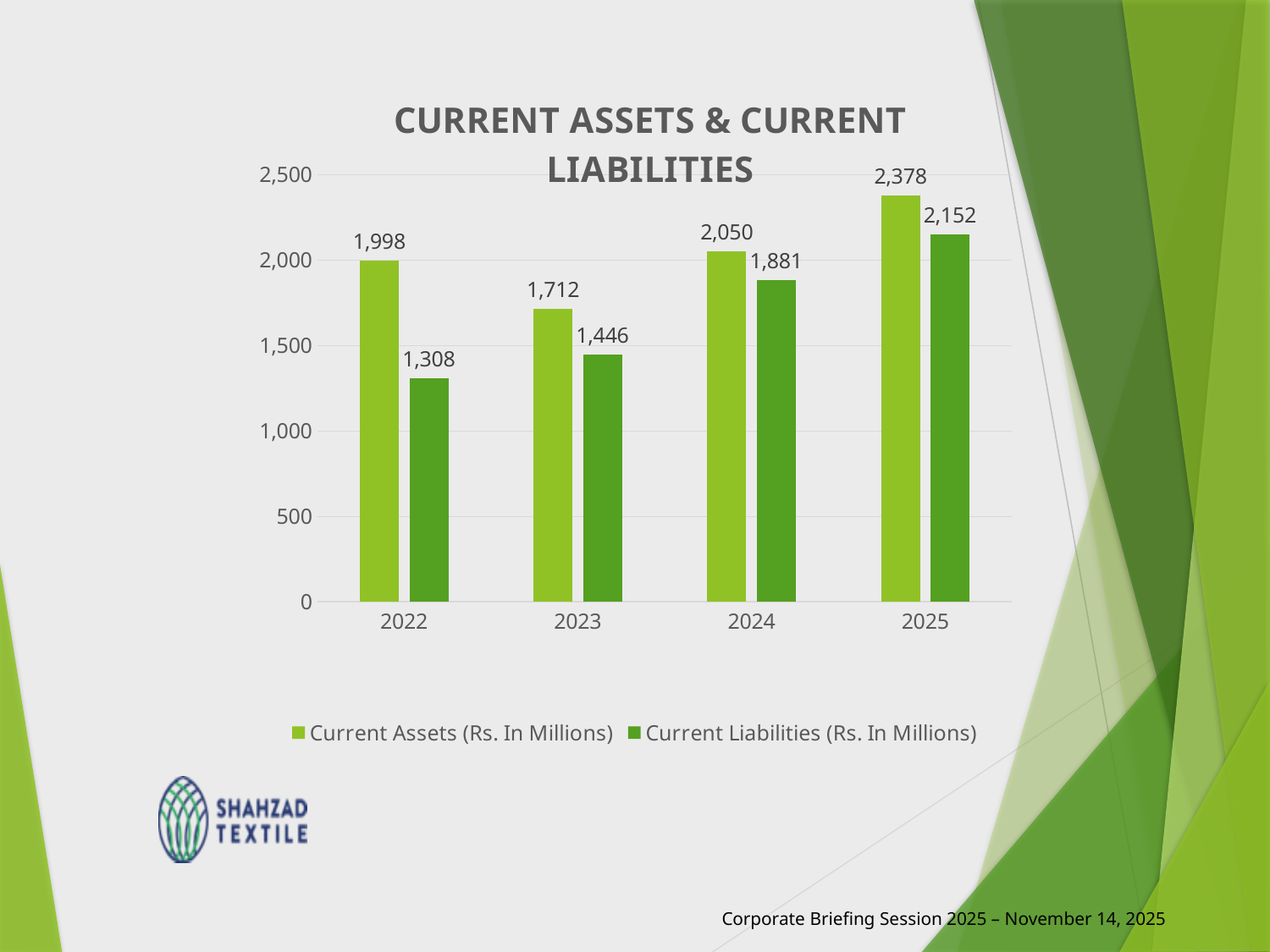
Is the value of Current Liabilities for 2022 greater or less than 1,500? less How many series does the legend list? 2 What is the value of Current Liabilities (Rs. In Millions) for 2025? 2,152 What is the value of Current Liabilities (Rs. In Millions) for 2023? 1,446 What is the difference between Current Assets and Current Liabilities in 2024? 169 Which year has the highest Current Assets (Rs. In Millions)? 2025 Do Current Liabilities rise or fall from 2022 to 2025? Rise What is the value of Current Assets (Rs. In Millions) for 2022? 1,998 How many years are shown on the x axis? 4 What kind of chart is shown on the slide? Bar chart Which year has the lowest Current Liabilities (Rs. In Millions)? 2022 Which is larger in 2023: Current Assets or Current Liabilities? Current Assets